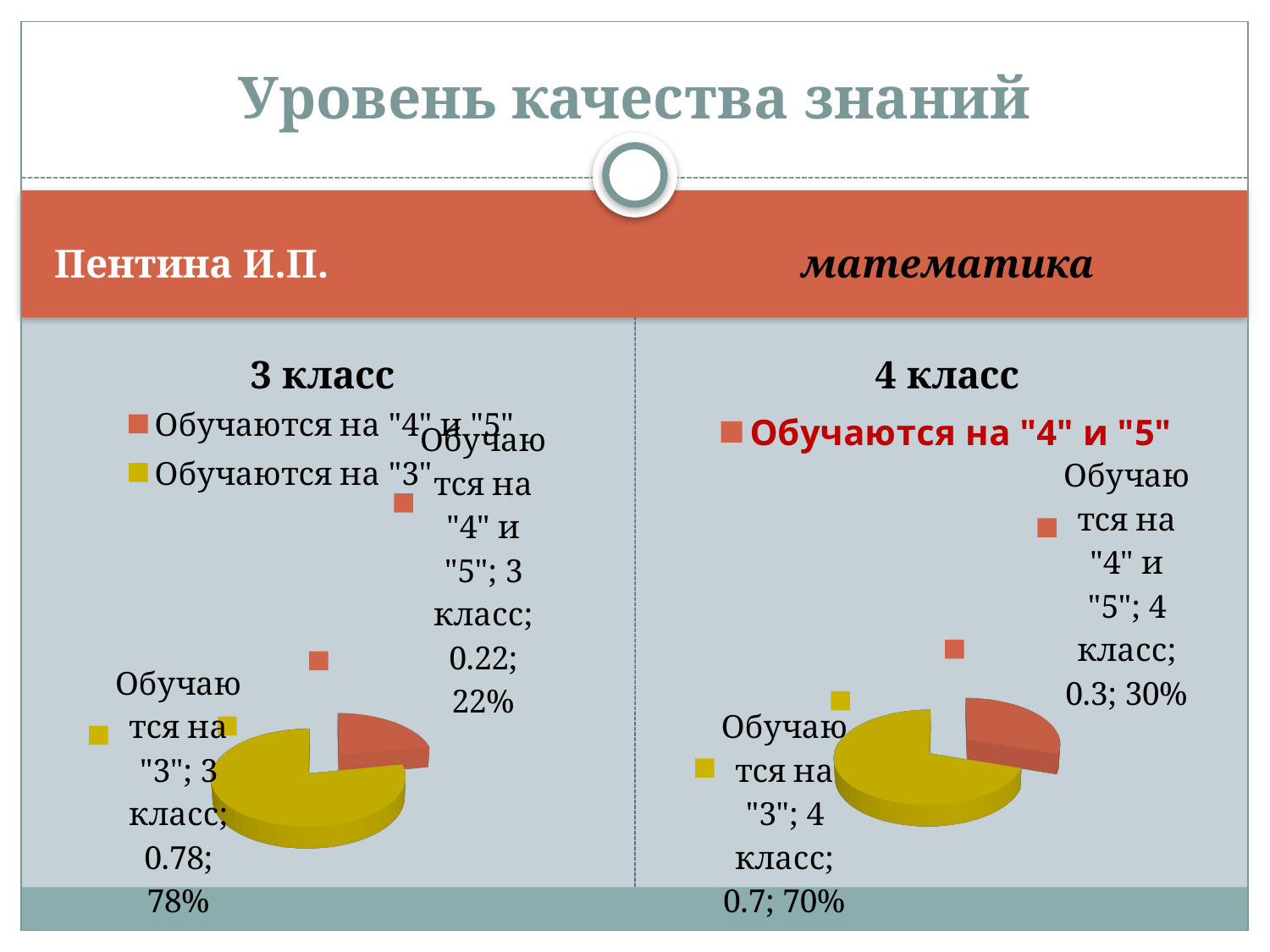
Сколько записей содержит легенда диаграммы «3 класс»? 2 На диаграмме «4 класс» на сколько процентных пунктов доля обучающихся на "3" больше доли обучающихся на "4" и "5"? 40 На диаграмме «3 класс» какая доля учеников обучается на "4" и "5"? 22% Сколько секторов на диаграмме «4 класс»? 2 Где доля обучающихся на "4" и "5" больше: на диаграмме «3 класс» или «4 класс»? 4 класс На диаграмме «3 класс» какая доля учеников обучается на "3"? 78% На диаграмме «4 класс» какая доля учеников обучается на "4" и "5"? 30% На диаграмме «3 класс» на сколько процентных пунктов доля обучающихся на "3" больше доли обучающихся на "4" и "5"? 56 Какого типа диаграмма «3 класс»? Круговая диаграмма На диаграмме «4 класс» какая категория занимает наименьшую долю? Обучаются на "4" и "5" На диаграмме «4 класс» какая доля учеников обучается на "3"? 70% На диаграмме «3 класс» какая категория занимает наибольшую долю? Обучаются на "3"